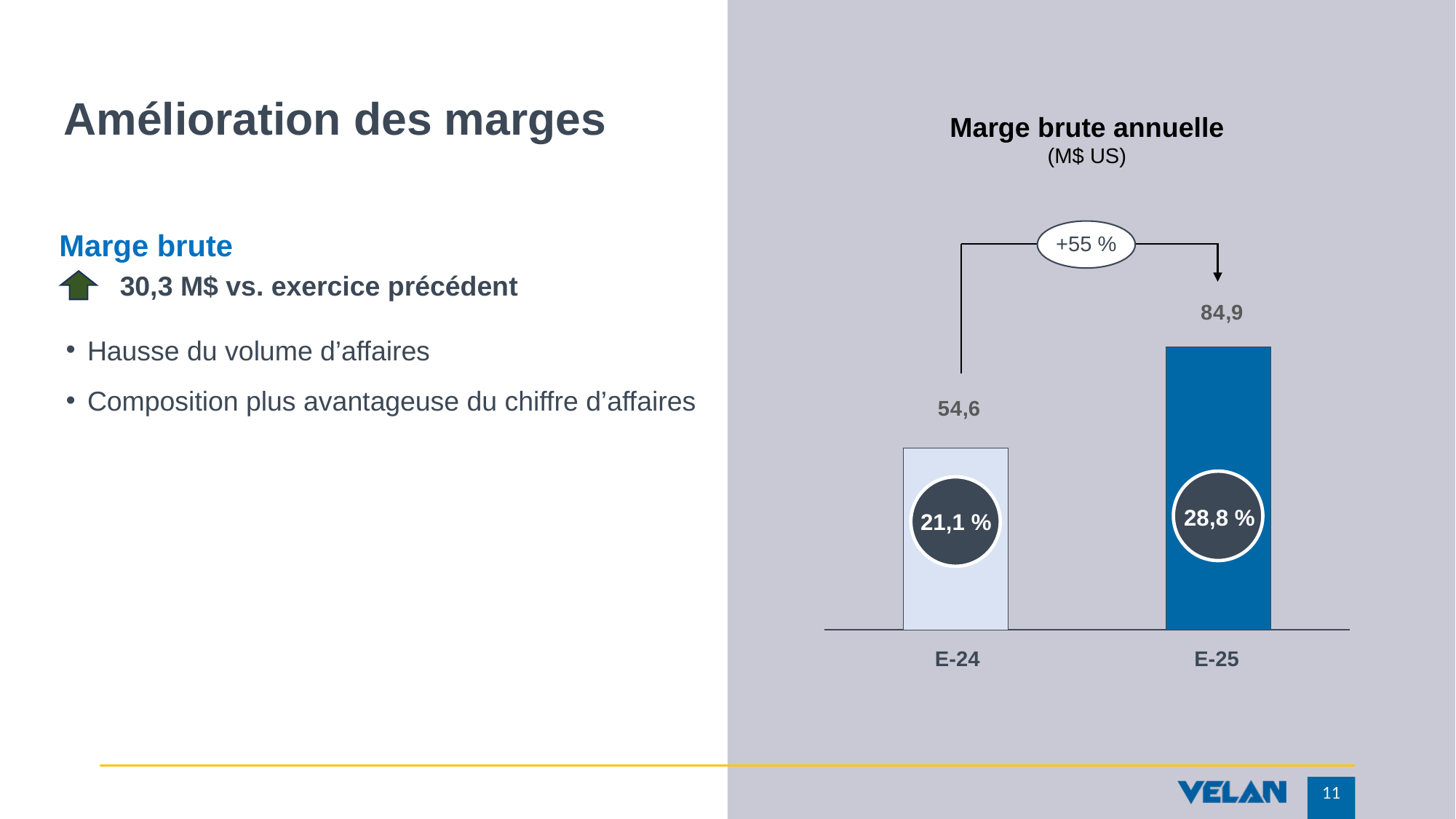
What gross margin percentage is shown inside the E-24 bar? 21,1 % What gross margin percentage is shown inside the E-25 bar? 28,8 % Which year has the higher annual gross margin in the chart? E-25 What is the difference between the E-25 and E-24 gross margin values in the chart? 30,3 Is the gross margin value for E-25 larger or smaller than the value for E-24? larger What is the gross margin value shown for E-24 in the 'Marge brute annuelle' chart? 54,6 What percentage change is shown in the oval between the two bars? +55 % What is the gross margin value shown for E-25 in the 'Marge brute annuelle' chart? 84,9 What type of chart is used to show the annual gross margin? bar chart What unit is indicated under the chart title 'Marge brute annuelle'? M$ US Which year has the lower annual gross margin in the chart? E-24 How many bars are plotted in the 'Marge brute annuelle' chart? 2